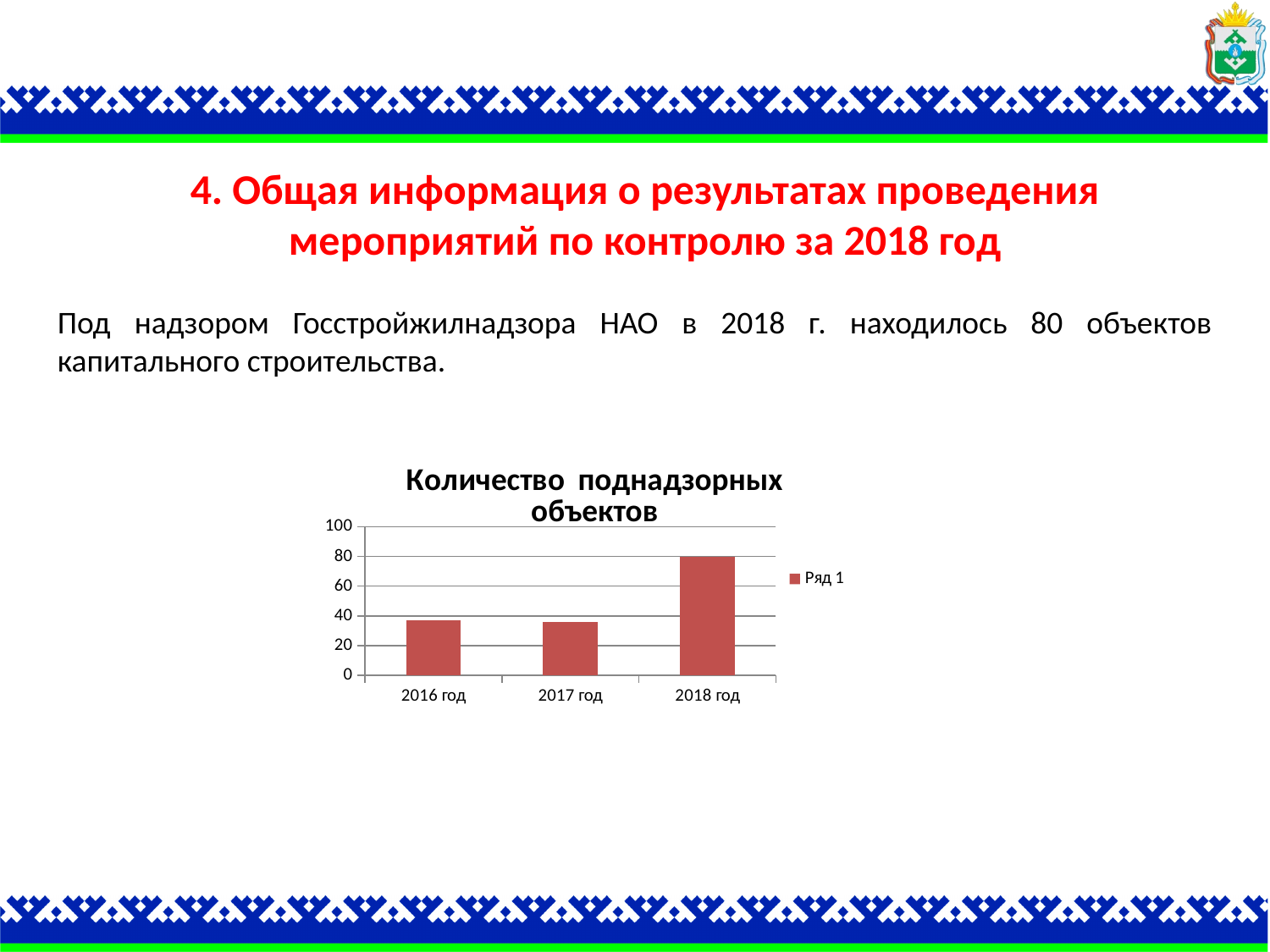
What is the title of the chart? Количество поднадзорных объектов How many years are shown on the x axis of the chart? 3 What is the value for 2018 год in the chart? 80 Is the value for 2016 год greater or less than 20? greater Is the value for 2016 год greater or less than 60? less Which year has the highest number of supervised objects in the chart? 2018 год Which is larger, the value for 2017 год or the value for 2018 год? 2018 год Which is larger, the value for 2018 год or the value for 2016 год? 2018 год Is the value for 2018 год greater or less than 60? greater What kind of chart is shown on the slide? bar chart How many series does the chart legend list? 1